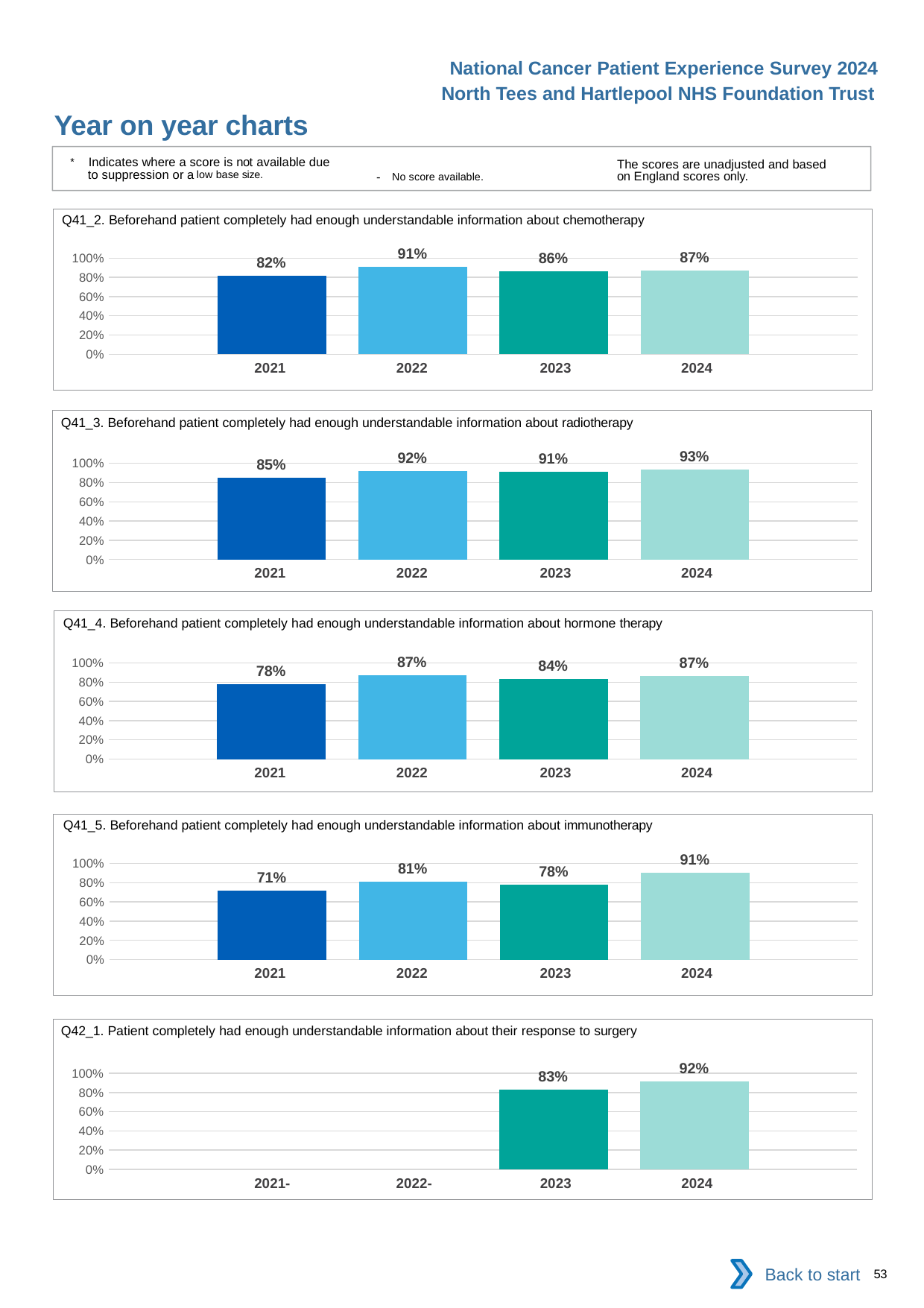
In the Q41_5 immunotherapy chart, what is the difference between the 2024 and 2021 values? 20% In the Q41_3 radiotherapy chart, what is the value for 2021? 85% In the Q41_4 hormone therapy chart, which year has the lowest value? 2021 What kind of chart is the Q41_5 immunotherapy chart? Bar chart In the Q41_2 chemotherapy chart, what is the value for 2022? 91% In the Q41_4 hormone therapy chart, what is the difference between the 2022 and 2023 values? 3% In the Q42_1 surgery chart, how many years have a bar plotted? 2 In the Q41_3 radiotherapy chart, which year has the highest value? 2024 In the Q41_5 immunotherapy chart, is the value for 2021 greater or less than 80%? less How many charts are shown on the slide? 5 In the Q41_2 chemotherapy chart, which is larger, the value for 2021 or the value for 2023? 2023 In the Q42_1 surgery chart, what is the value for 2023? 83%